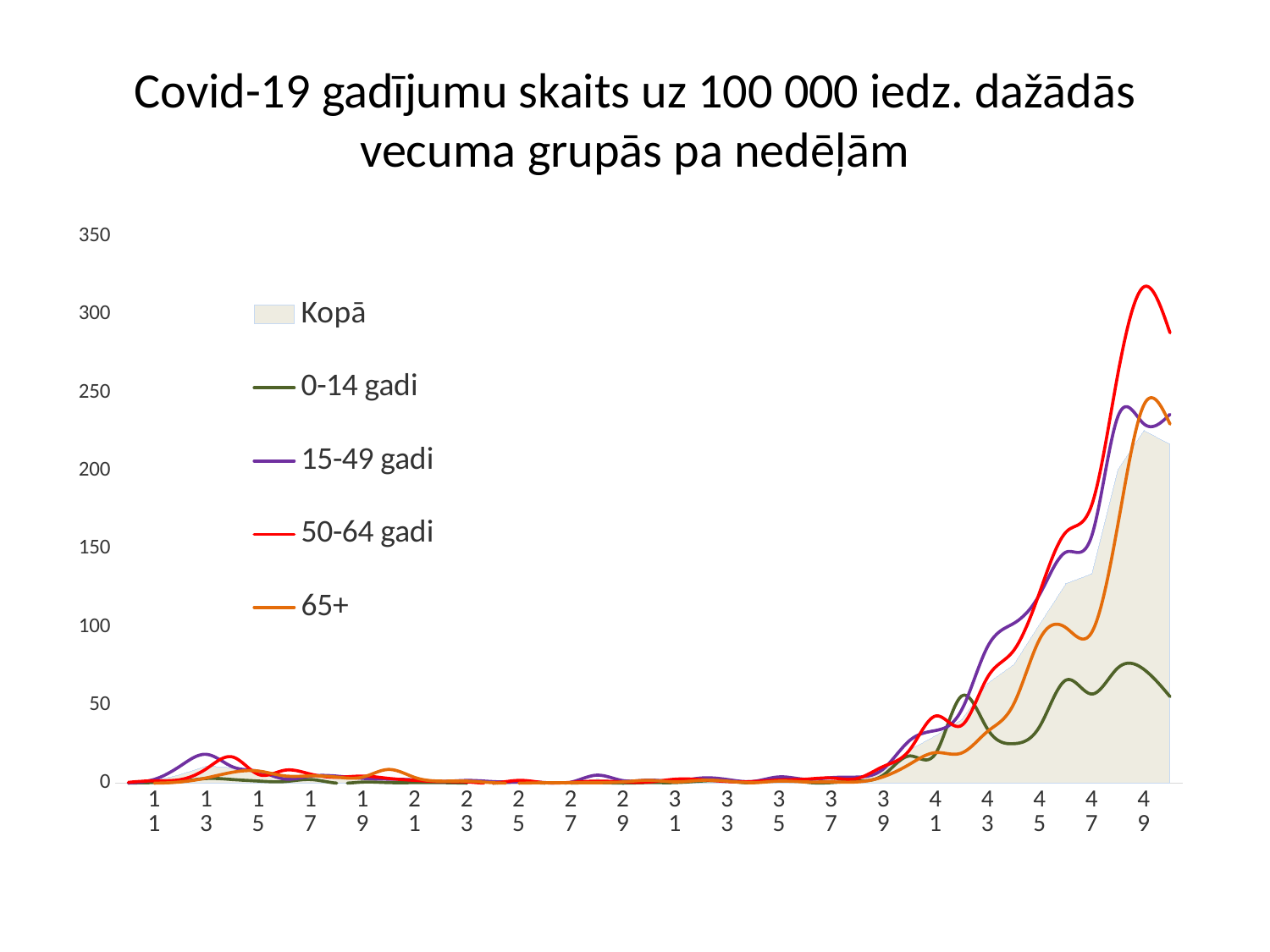
How many series does the legend list? 5 What kind of chart is shown on the slide? combination area and line chart Which series reaches the highest value on the chart? 50-64 gadi Is the peak value for 0-14 gadi greater or less than 100? less How many week labels are shown on the x axis? 20 What is the title of the chart? Covid-19 gadījumu skaits uz 100 000 iedz. dažādās vecuma grupās pa nedēļām At week 49, which is higher: 50-64 gadi or 0-14 gadi? 50-64 gadi Is the value for 65+ at week 49 greater or less than 200? greater Which series has the lowest peak value on the chart? 0-14 gadi What colour is the 15-49 gadi line in the legend? purple Is the peak value for 50-64 gadi greater or less than 300? greater Do the values for 50-64 gadi rise or fall between week 39 and week 49? rise